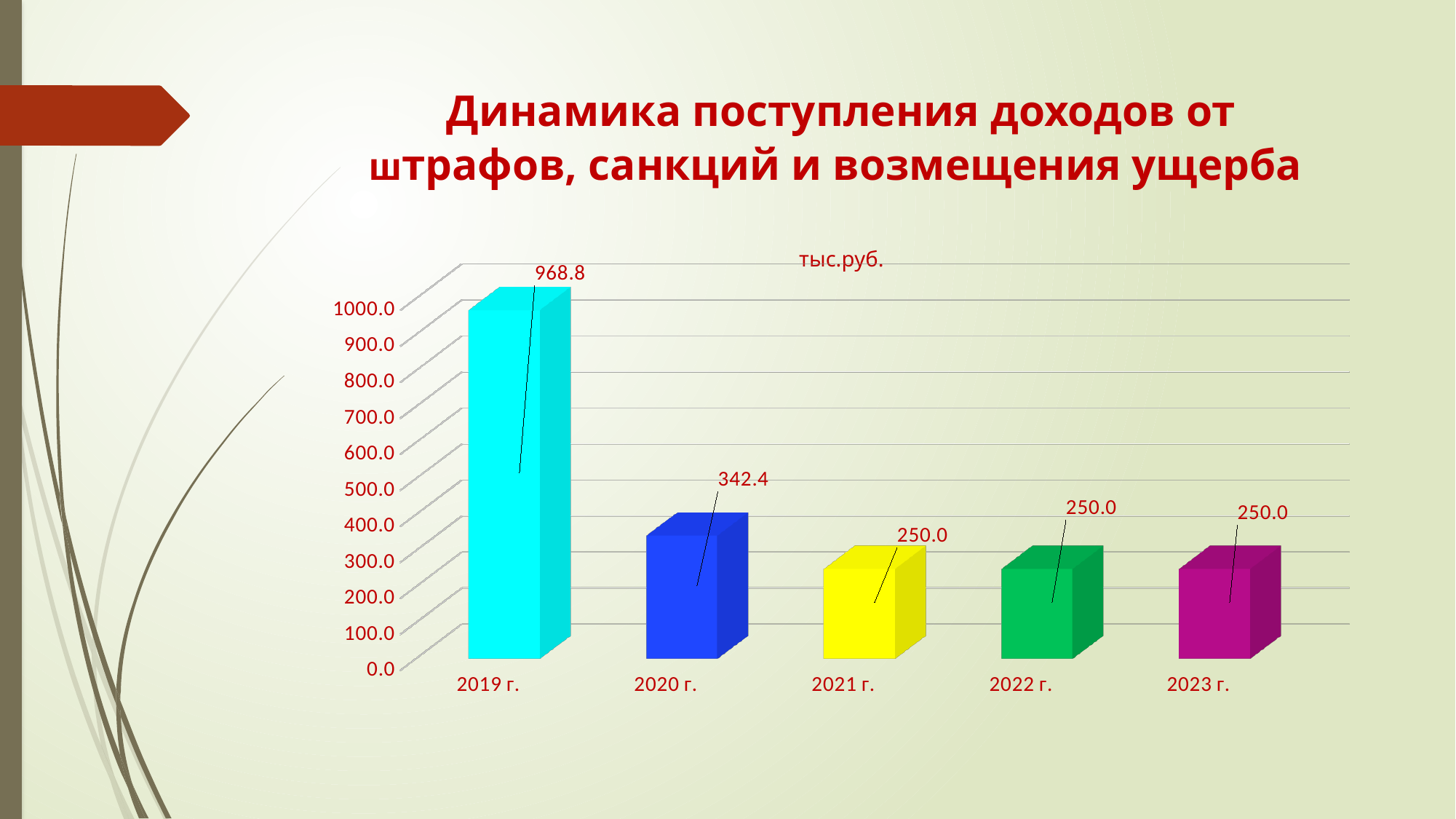
What kind of chart is shown on the slide? bar chart Is the value for 2019 г. greater or less than 900.0? greater Which year has the highest value? 2019 г. What is the difference between the values for 2019 г. and 2020 г.? 626.4 What is the value for 2019 г.? 968.8 What is the difference between the values for 2020 г. and 2021 г.? 92.4 What is the value for 2021 г.? 250.0 Which is larger, the value for 2020 г. or the value for 2022 г.? 2020 г. How many years are shown on the x axis? 5 What is the value for 2020 г.? 342.4 What is the value for 2023 г.? 250.0 What unit label is shown above the chart? тыс.руб.